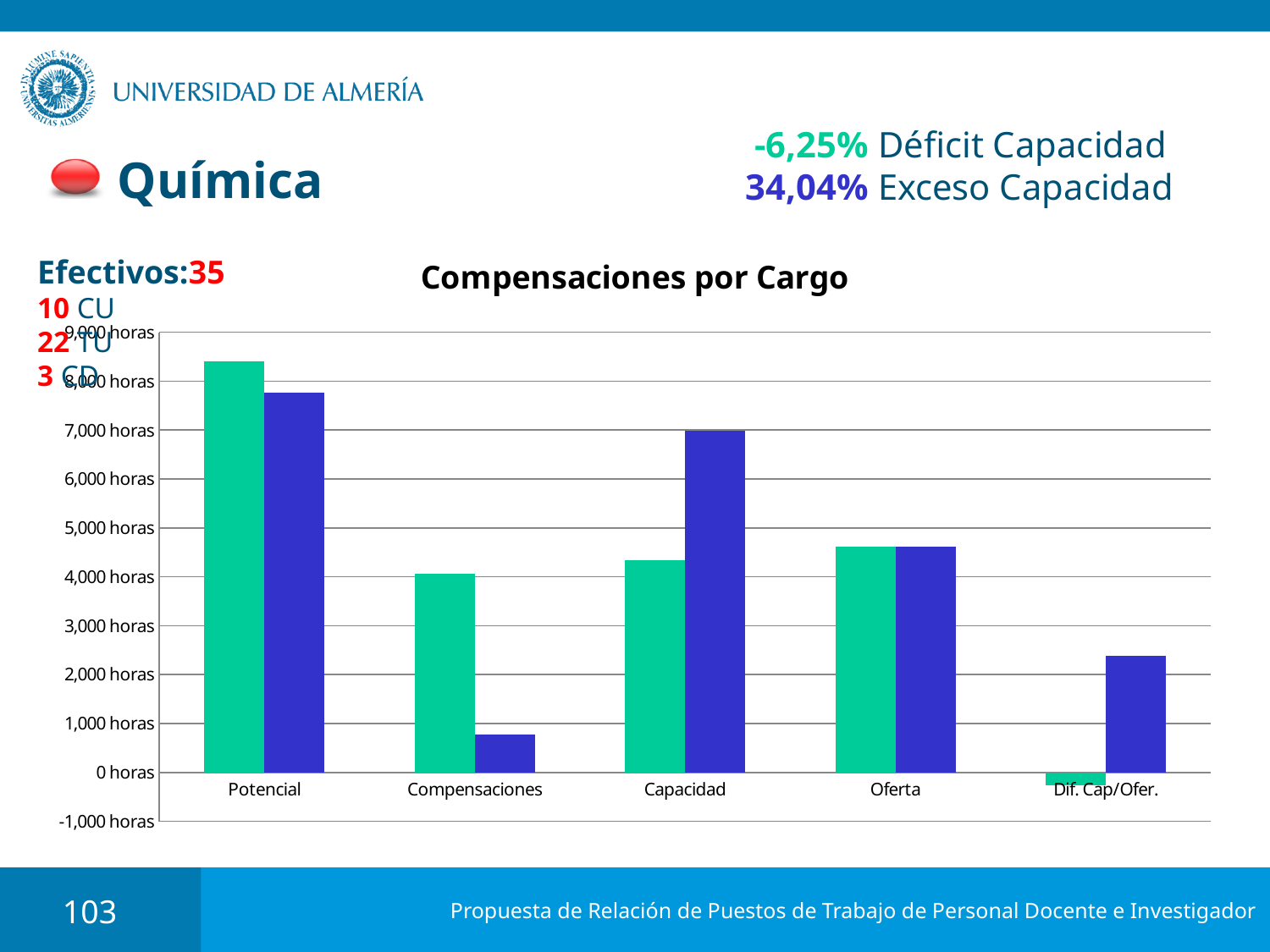
Is the value of the green bar for Potencial greater or less than 8,000 horas? greater Is the value of the blue bar for Dif. Cap/Ofer. greater or less than 2,000 horas? greater For Compensaciones, which bar is taller, the green one or the blue one? the green one What is the title of the chart on the slide? Compensaciones por Cargo How many categories are shown on the x axis of the chart? 5 Is the value of the blue bar for Compensaciones greater or less than 1,000 horas? less For Capacidad, which bar is taller, the green one or the blue one? the blue one How many bars are plotted for each category in the chart? 2 What kind of chart is shown on the slide? bar chart Which category has the tallest green bar? Potencial Which category has the shortest blue bar? Compensaciones